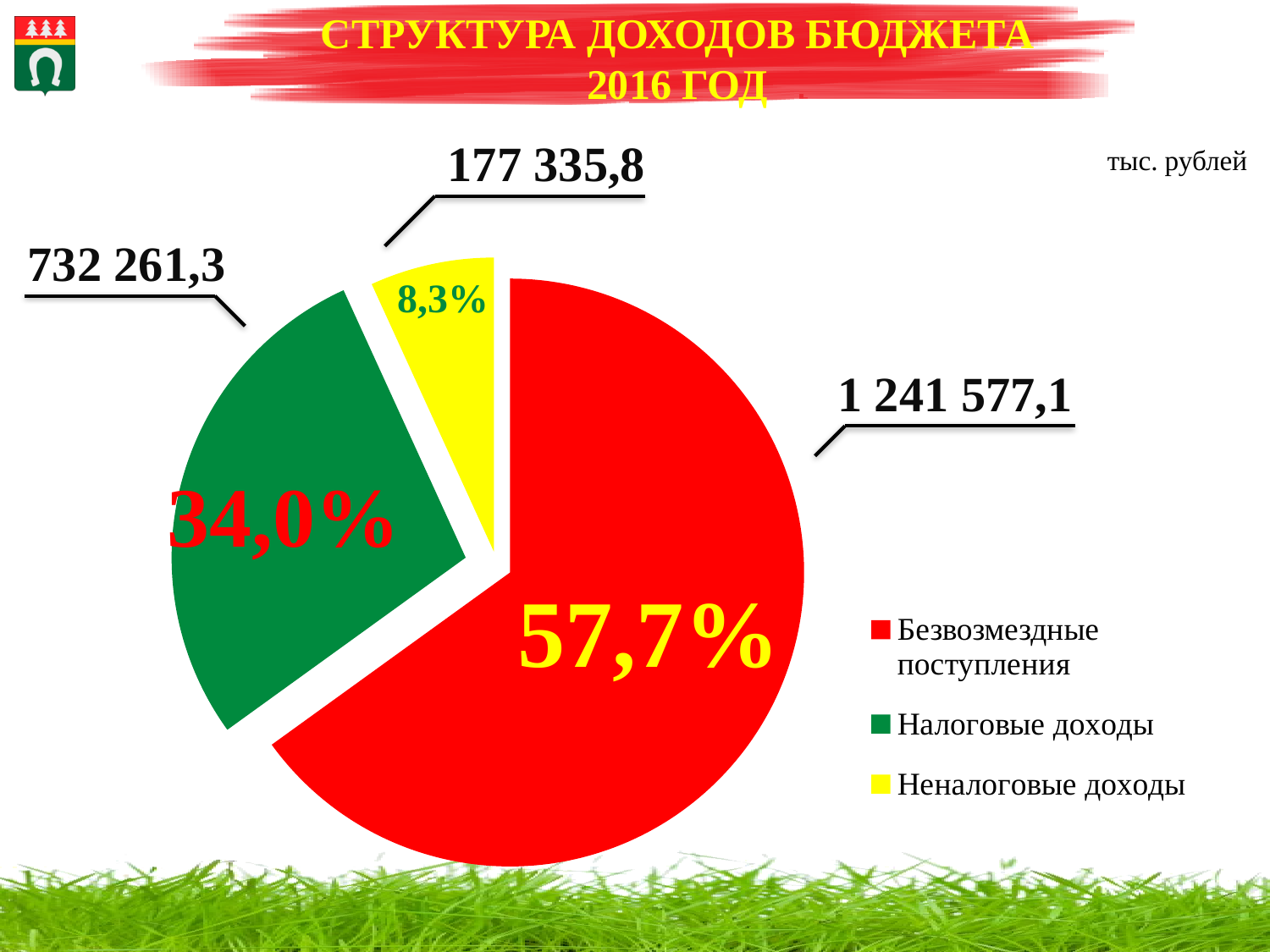
How many categories does the pie chart have? 3 What unit is stated for the values on the chart? тыс. рублей What type of chart is shown on the slide? pie chart What is the value for Безвозмездные поступления? 1 241 577,1 What share of the pie does Безвозмездные поступления take? 57,7% What is the value for Неналоговые доходы? 177 335,8 What is the value for Налоговые доходы? 732 261,3 What is the difference between the values for Безвозмездные поступления and Налоговые доходы? 509 315,8 Which category has the largest slice? Безвозмездные поступления Which category has the smallest slice? Неналоговые доходы What share of the pie does Неналоговые доходы take? 8,3% What share of the pie does Налоговые доходы take? 34,0%